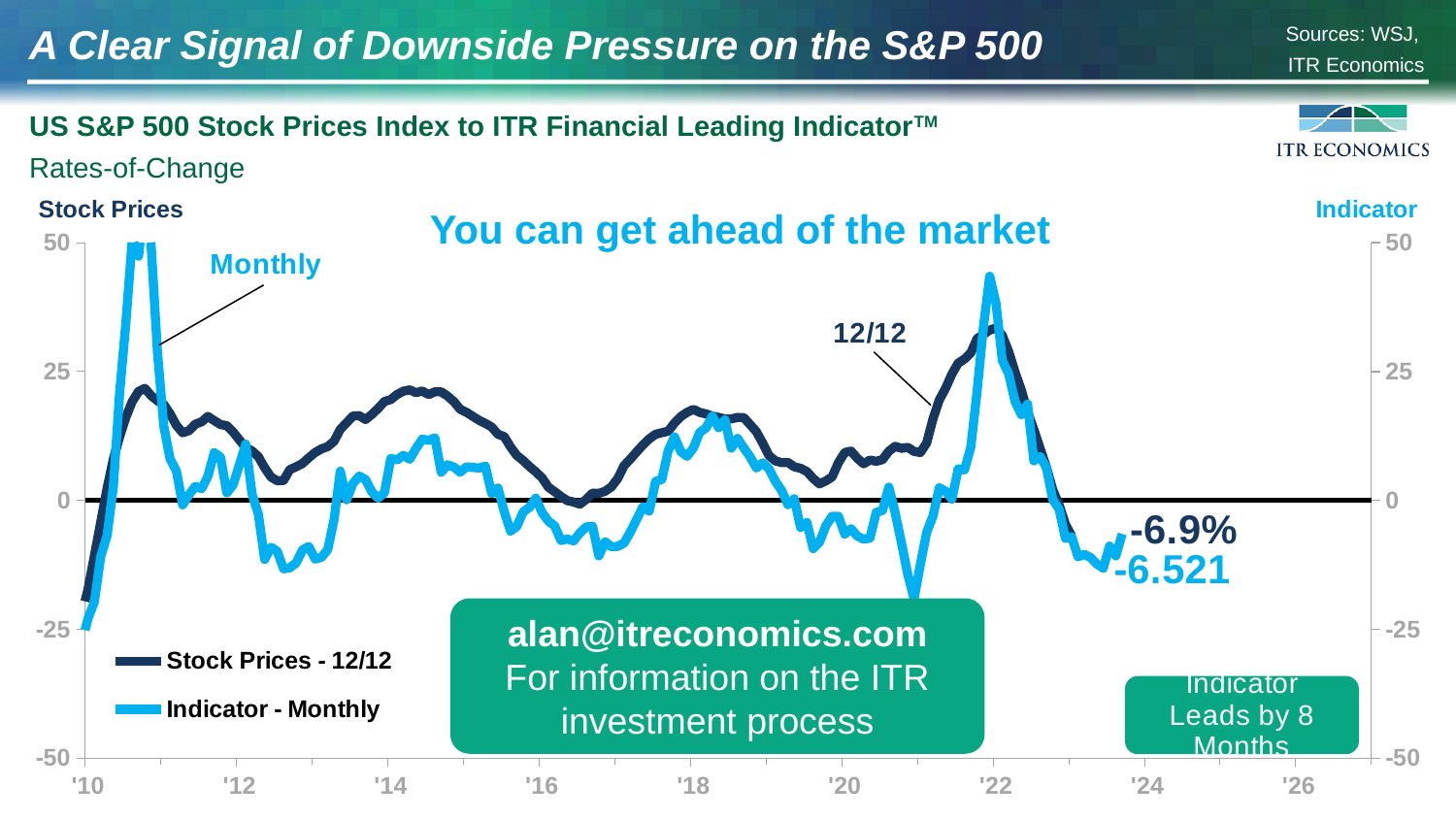
What is the chart's title? US S&P 500 Stock Prices Index to ITR Financial Leading Indicator™ Is the peak of the Indicator - Monthly series around 2011 greater or less than 25? greater Is the peak of the Stock Prices - 12/12 series around 2022 greater or less than 25? greater At the latest labelled point, which series has the lower value, Stock Prices - 12/12 or Indicator - Monthly? Stock Prices - 12/12 What is the latest labelled value of the Stock Prices - 12/12 series? -6.9% What kind of chart is shown on the slide? line chart Around 2022, which series reaches the higher peak, Stock Prices - 12/12 or Indicator - Monthly? Indicator - Monthly Is the low point of the Indicator - Monthly series around 2021 greater or less than 0? less Between 2022 and 2023, does the Stock Prices - 12/12 series rise or fall? fall What is the latest labelled value of the Indicator - Monthly series? -6.521 What are the two series named in the chart legend? Stock Prices - 12/12 and Indicator - Monthly How many series does the chart legend list? 2